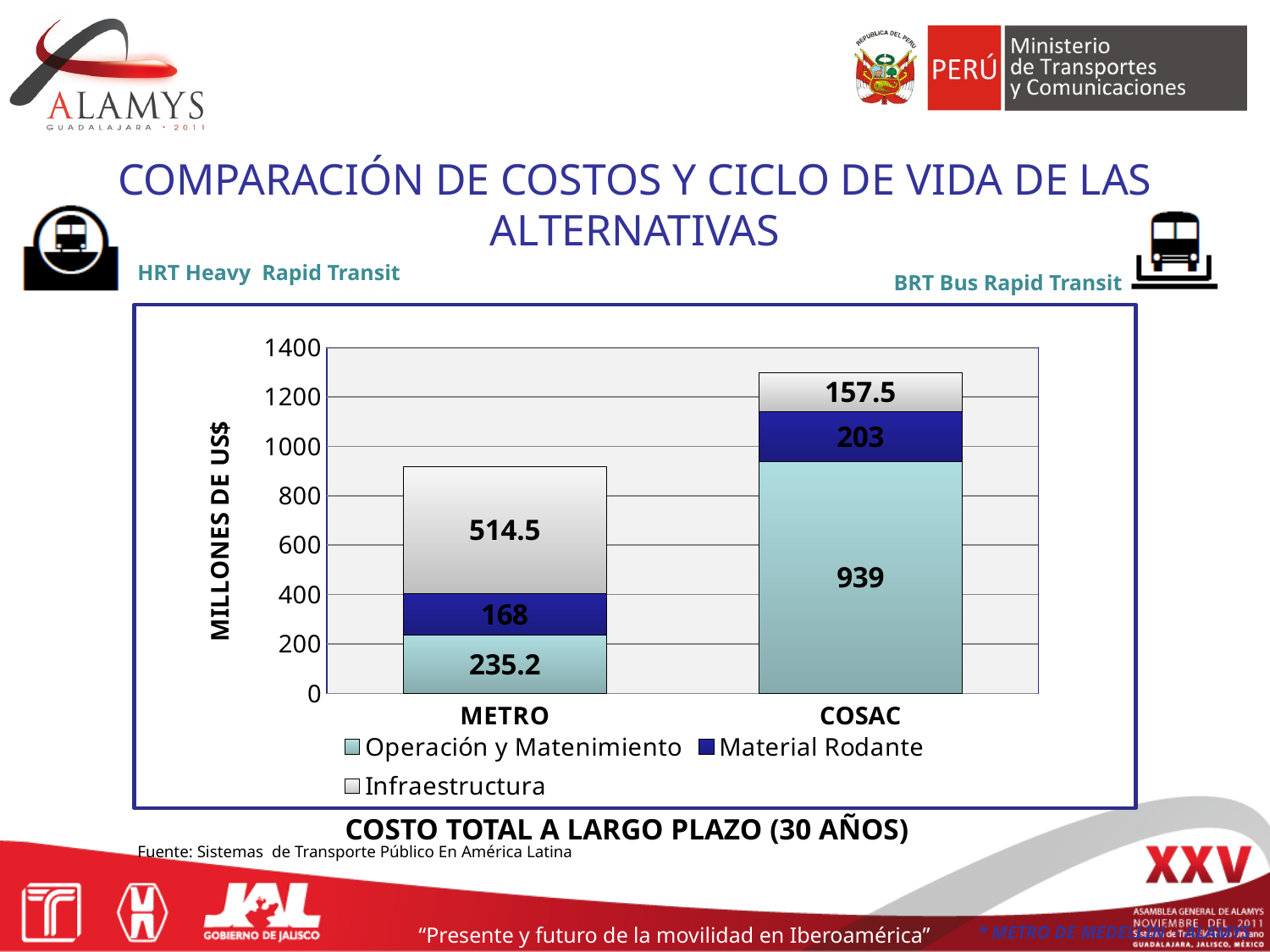
What is the Material Rodante value for METRO? 168 What is the Operación y Matenimiento value for COSAC? 939 What is the Infraestructura value for METRO? 514.5 What is the total of the stacked bar for COSAC? 1299.5 What is the Infraestructura value for COSAC? 157.5 What kind of chart is shown on the slide? Stacked bar chart What is the difference between the Material Rodante values for COSAC and METRO? 35 What is the label of the vertical axis? MILLONES DE US$ How many series does the legend list? 3 Which category has the higher total stacked bar? COSAC Which category has the larger Infraestructura value, METRO or COSAC? METRO What is the total of the stacked bar for METRO? 917.7